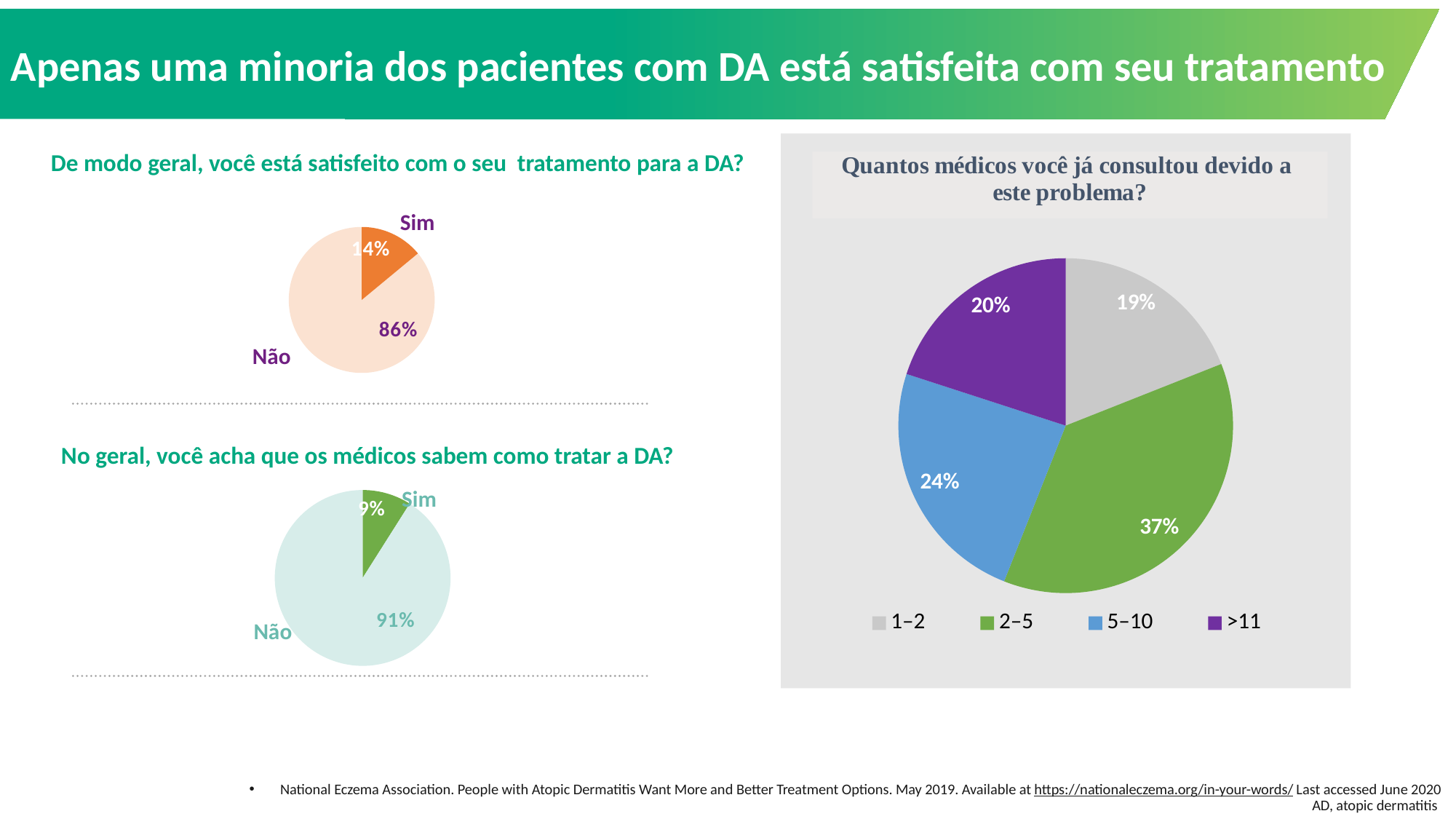
In the right-hand pie chart ("Quantos médicos você já consultou devido a este problema?"), which category has the largest share? 2–5 In the bottom-left pie chart ("No geral, você acha que os médicos sabem como tratar a DA?"), what is the difference between the "Não" and "Sim" shares? 82% In the bottom-left pie chart ("No geral, você acha que os médicos sabem como tratar a DA?"), what share of patients answered "Sim"? 9% In the top-left pie chart ("De modo geral, você está satisfeito com o seu tratamento para a DA?"), what share of patients answered "Sim"? 14% In the right-hand pie chart ("Quantos médicos você já consultou devido a este problema?"), which is larger: the share for 5–10 or the share for >11? 5–10 In the top-left pie chart ("De modo geral, você está satisfeito com o seu tratamento para a DA?"), what share of patients answered "Não"? 86% In the right-hand pie chart ("Quantos médicos você já consultou devido a este problema?"), which category has the smallest share? 1–2 What type of chart is used for "Quantos médicos você já consultou devido a este problema?"? Pie chart In the right-hand pie chart ("Quantos médicos você já consultou devido a este problema?"), what share of patients consulted 5–10 doctors? 24% In the right-hand pie chart ("Quantos médicos você já consultou devido a este problema?"), what share of patients consulted 2–5 doctors? 37% In the right-hand pie chart ("Quantos médicos você já consultou devido a este problema?"), how many categories does the legend list? 4 In the right-hand pie chart ("Quantos médicos você já consultou devido a este problema?"), what is the difference between the 2–5 share and the >11 share? 17%